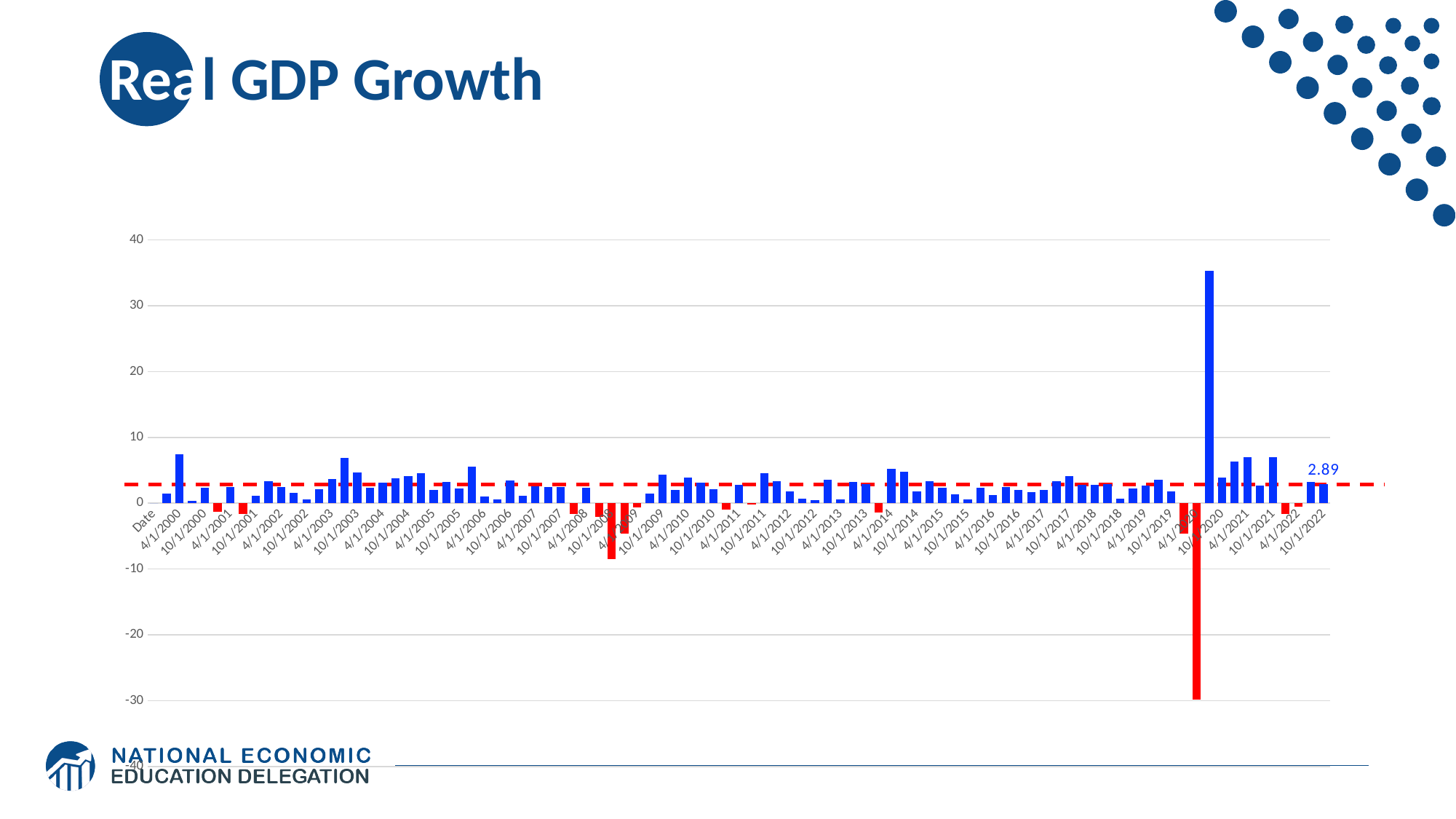
Is the value for 10/1/2021 greater or less than 5? greater In which year does the lowest bar on the chart occur? 2020 Is the value for 10/1/2022 greater or less than 0? greater What is the title of the chart? Real GDP Growth Is the value of the tallest bar greater or less than 30? greater What kind of chart is shown on the slide? bar chart What value is labelled on the dashed red horizontal line? 2.89 Which is larger, the value for 4/1/2020 or the value for 10/1/2022? 10/1/2022 In which year does the tallest bar on the chart occur? 2020